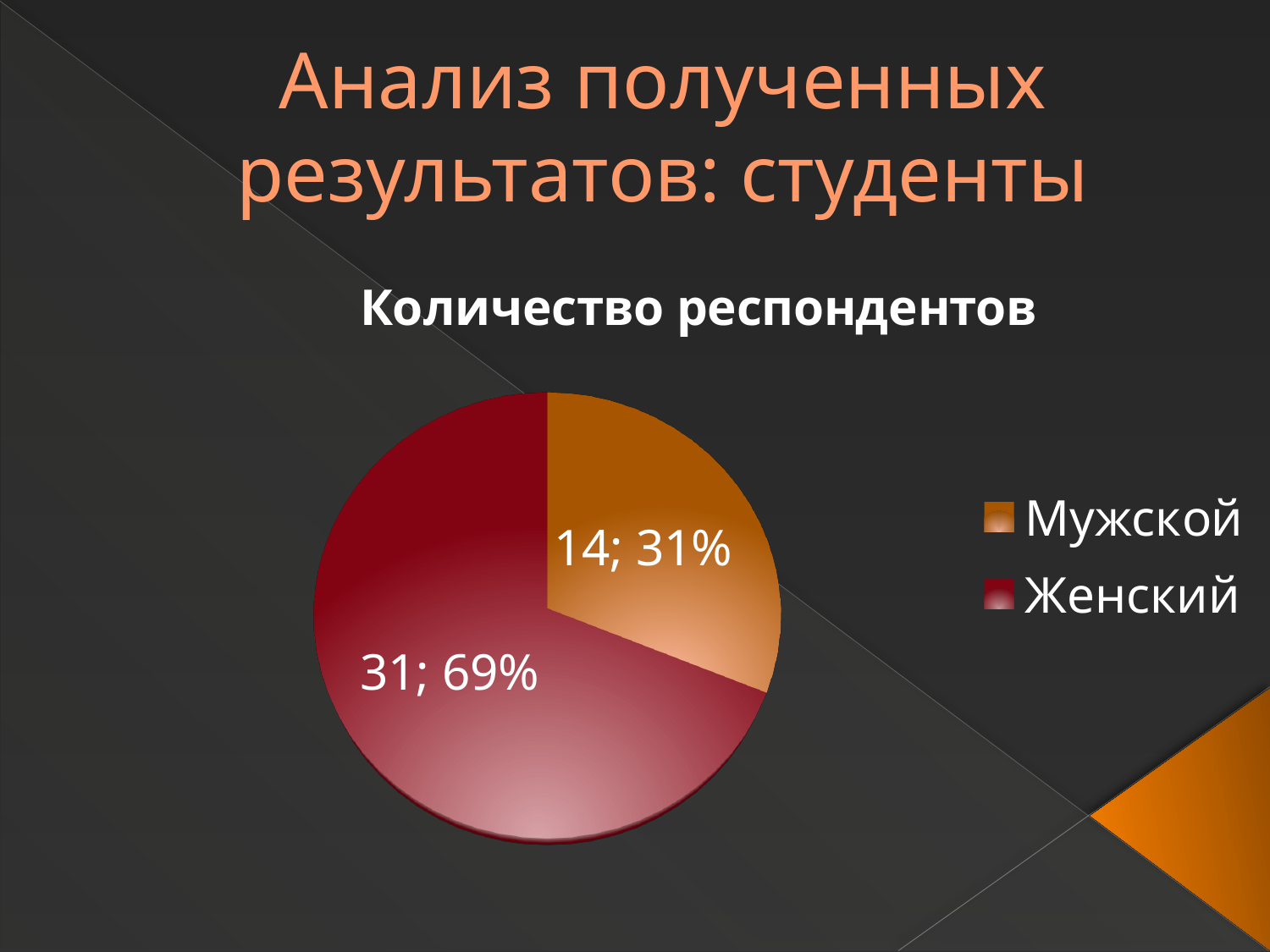
What is the title of the chart? Количество респондентов What is the total number of respondents shown in the pie chart? 45 What is the difference in respondents between Женский and Мужской? 17 What share of the pie does the Женский slice represent? 69% How many slices does the pie chart have? 2 What type of chart is shown on the slide? pie chart What share of the pie does the Мужской slice represent? 31% Which category has the largest slice? Женский What is the number of respondents for Женский? 31 What is the number of respondents for Мужской? 14 How many categories does the legend list? 2 Which category has the smallest slice? Мужской